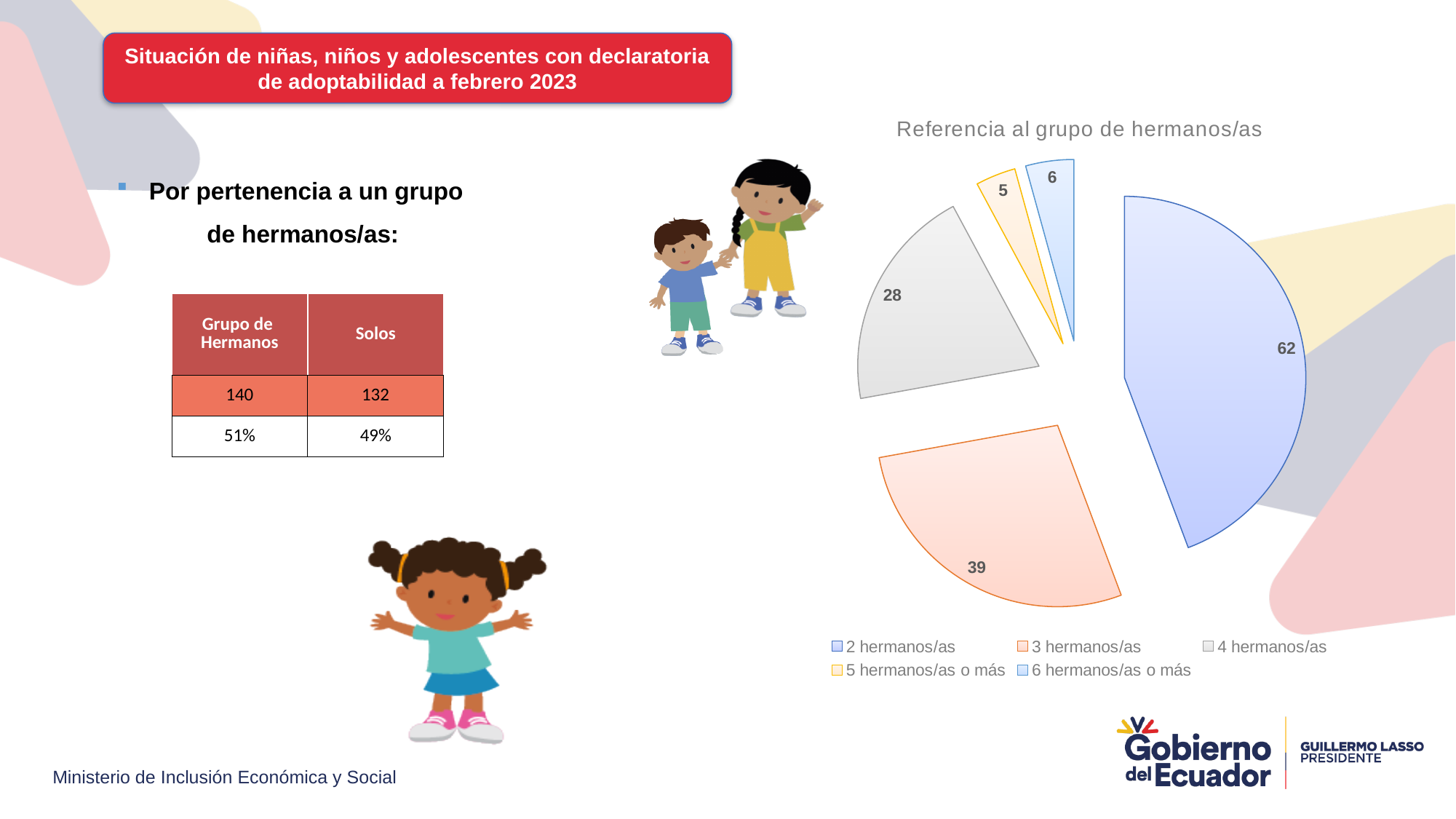
In the pie chart, what is the value for "5 hermanos/as o más"? 5 Which category has the smallest slice in the pie chart? 5 hermanos/as o más In the pie chart, what is the value for "4 hermanos/as"? 28 How many categories does the legend of the pie chart list? 5 In the pie chart, what is the value for "2 hermanos/as"? 62 In the pie chart, which is larger: the value for "4 hermanos/as" or the value for "3 hermanos/as"? 3 hermanos/as Which category has the largest slice in the pie chart? 2 hermanos/as In the pie chart, what is the difference between the values for "2 hermanos/as" and "3 hermanos/as"? 23 In the pie chart, what is the value for "6 hermanos/as o más"? 6 What is the sum of all the slice values in the pie chart? 140 In the pie chart, what is the value for "3 hermanos/as"? 39 What kind of chart is shown under the title "Referencia al grupo de hermanos/as"? Pie chart